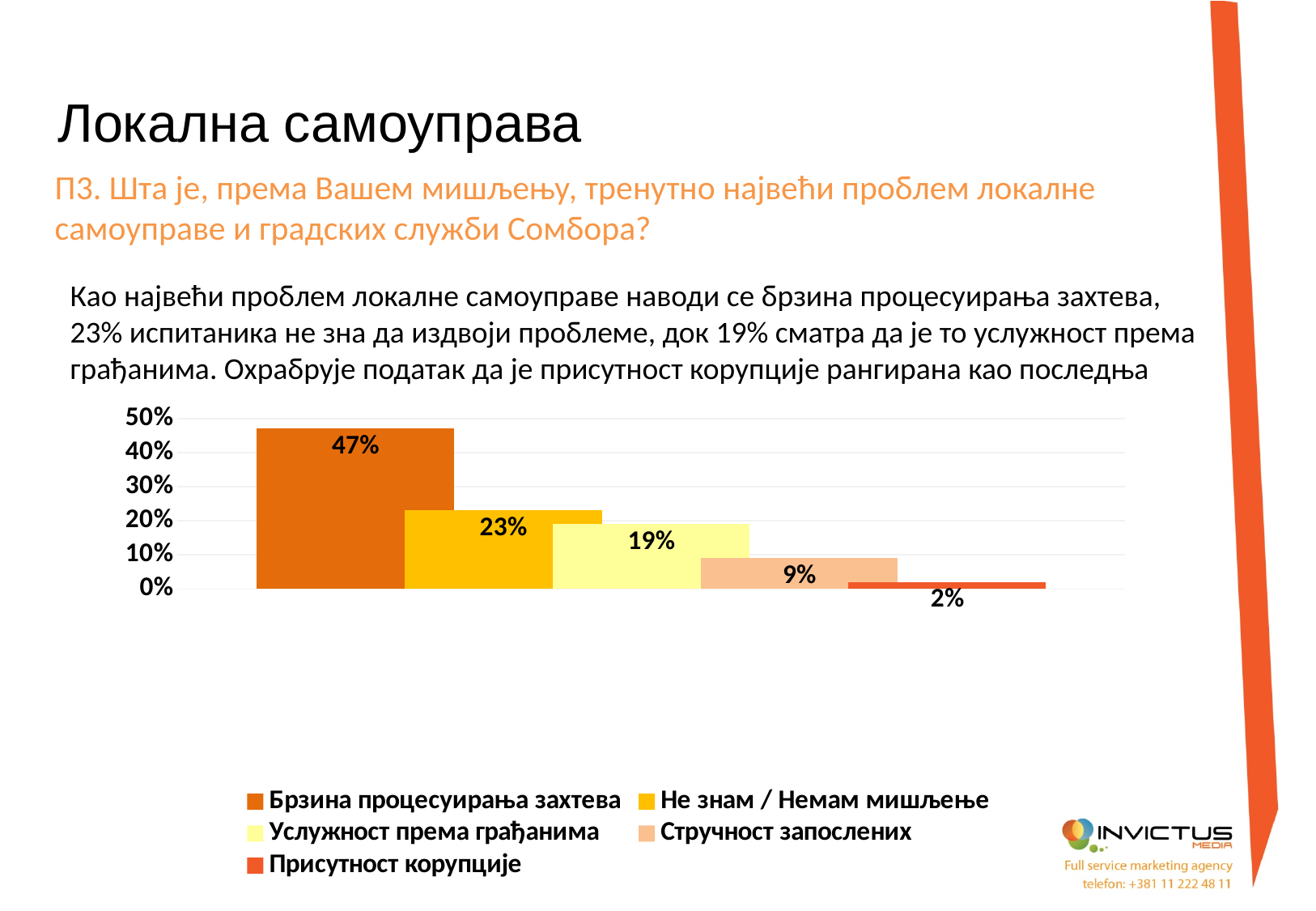
What is the value for Присутност корупције? 2% How many series does the legend list? 5 What is the difference between the values for Брзина процесуирања захтева and Не знам / Немам мишљење? 24% What kind of chart is shown on the slide? Bar chart Which category has the lowest value? Присутност корупције What colour is the bar for Брзина процесуирања захтева? Dark orange What is the value for Не знам / Немам мишљење? 23% What is the value for Стручност запослених? 9% Which is larger, the value for Услужност према грађанима or the value for Стручност запослених? Услужност према грађанима What is the value for Брзина процесуирања захтева? 47% Which category has the highest value? Брзина процесуирања захтева What is the value for Услужност према грађанима? 19%